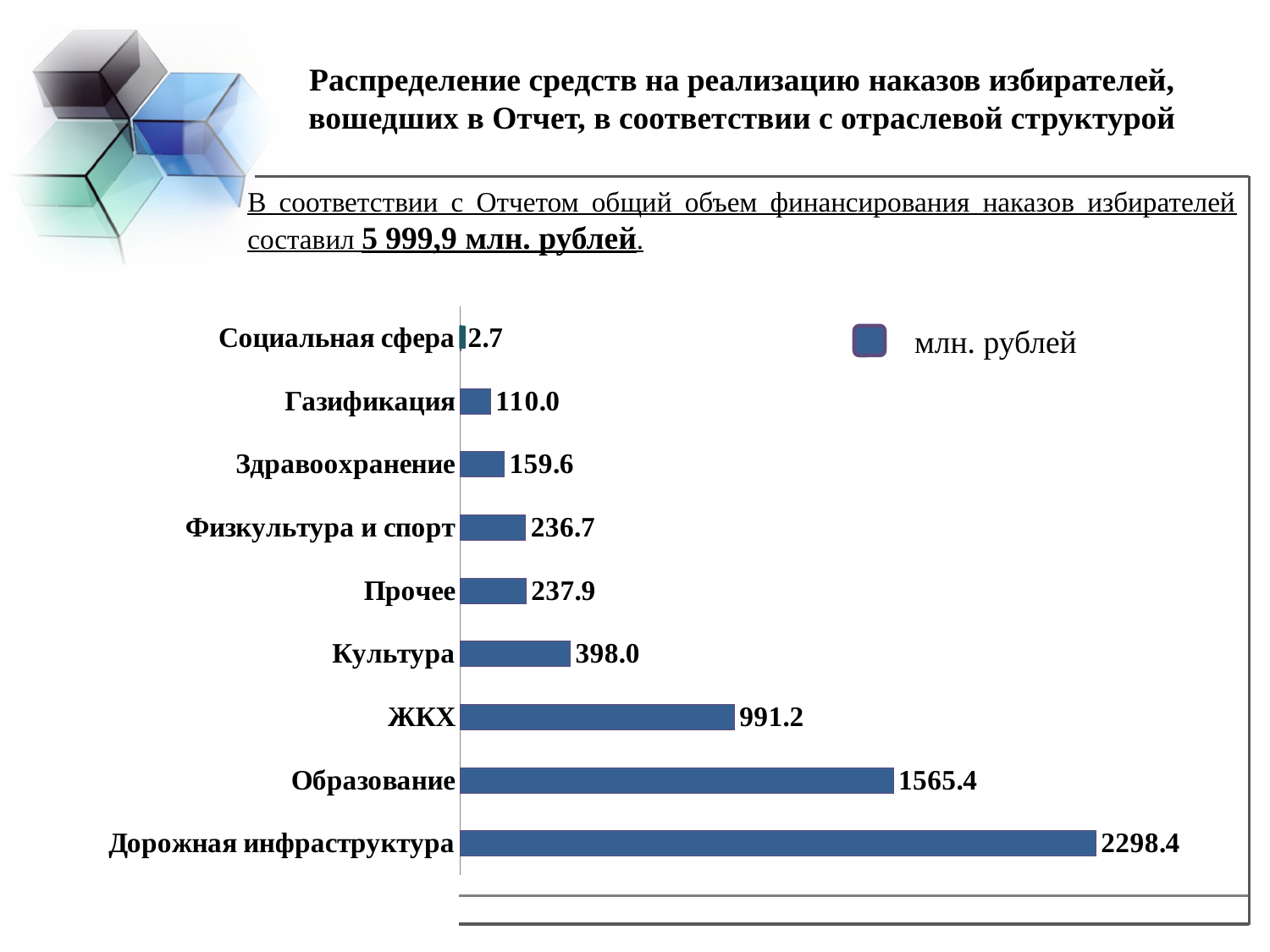
What is the value for Газификация? 110.0 What kind of chart is shown on the slide? Bar chart Which is larger, the value for ЖКХ or the value for Культура? ЖКХ What is the value for Дорожная инфраструктура? 2298.4 What is the difference between the values for Дорожная инфраструктура and Образование? 733.0 What is the value for ЖКХ? 991.2 What is the difference between the values for Культура and Здравоохранение? 238.4 How many series does the legend list? 1 Which category has the highest value? Дорожная инфраструктура Which category has the lowest value? Социальная сфера How many categories are shown in the chart? 9 What is the legend entry of the chart? млн. рублей